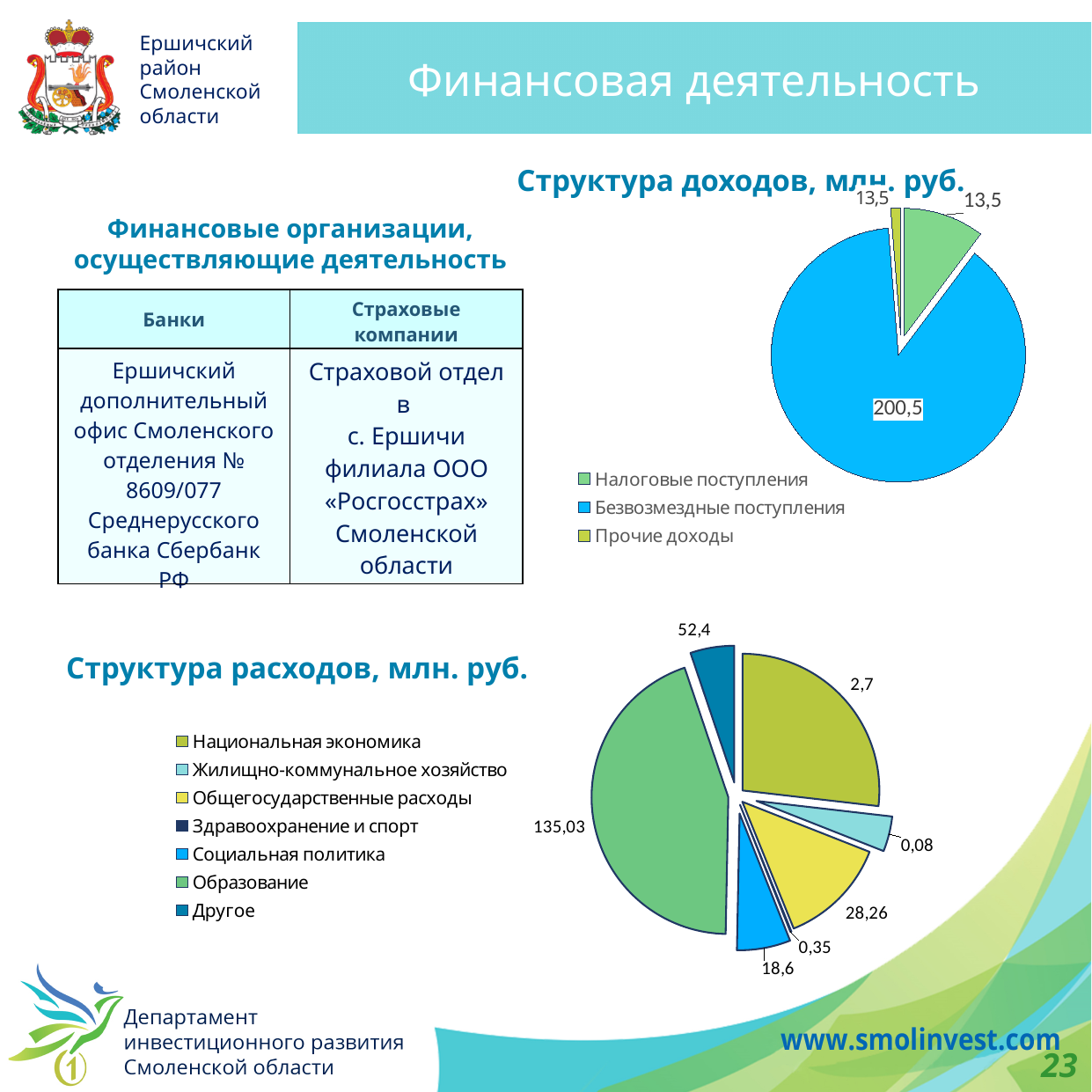
In the chart 'Структура доходов, млн. руб.', how many categories does the legend list? 3 In the chart 'Структура расходов, млн. руб.', what is the difference between Образование and Национальная экономика? 132,33 In the chart 'Структура расходов, млн. руб.', what is the value for Общегосударственные расходы? 28,26 In the chart 'Структура расходов, млн. руб.', how many categories does the legend list? 7 In the chart 'Структура расходов, млн. руб.', what is the value for Образование? 135,03 In the chart 'Структура расходов, млн. руб.', which category has the smallest value? Жилищно-коммунальное хозяйство In the chart 'Структура доходов, млн. руб.', what is the value for Безвозмездные поступления? 200,5 In the chart 'Структура доходов, млн. руб.', which category has the largest slice? Безвозмездные поступления In the chart 'Структура расходов, млн. руб.', what is the value for Жилищно-коммунальное хозяйство? 0,08 In the chart 'Структура расходов, млн. руб.', what is the value for Социальная политика? 18,6 What kind of chart is 'Структура доходов, млн. руб.'? pie chart In the chart 'Структура расходов, млн. руб.', which is larger: Общегосударственные расходы or Социальная политика? Общегосударственные расходы